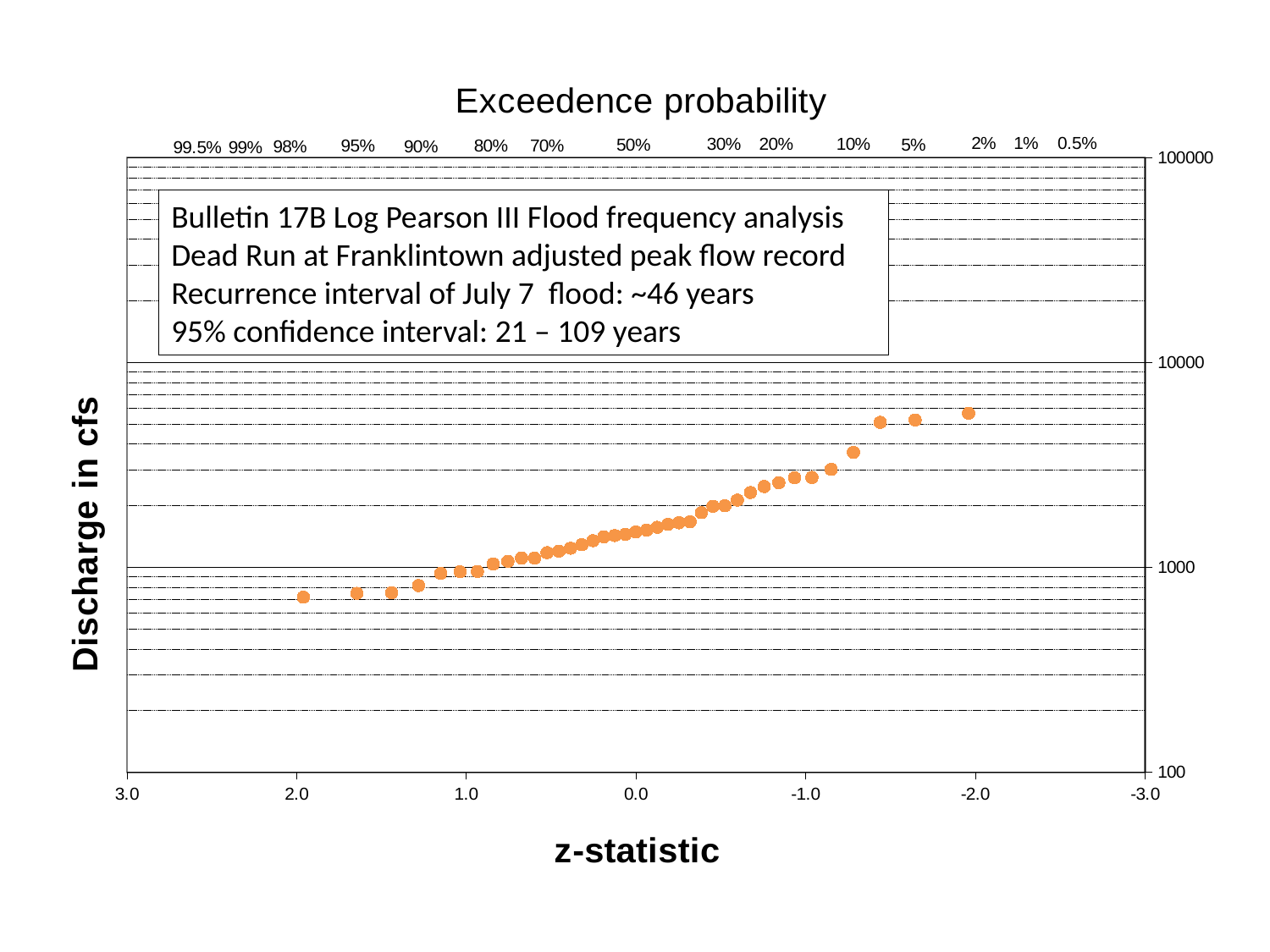
Is the discharge of the point near z-statistic 0.0 greater or less than 1000 cfs? greater What exceedance probability is shown on the top axis above z-statistic 0.0? 50% As the z-statistic decreases from 2.0 to -2.0 (moving right along the x axis), does the discharge rise or fall? rise What is the label of the y axis? Discharge in cfs Is the highest discharge point on the chart greater or less than 10000 cfs? less Near which z-statistic tick does the point with the lowest discharge occur? 2.0 Is the lowest discharge point on the chart greater or less than 100 cfs? greater Near which z-statistic tick does the point with the highest discharge occur? -2.0 What kind of chart is shown on the slide? scatter chart Which has the larger discharge: the point near z-statistic -2.0 or the point near z-statistic 2.0? the point near -2.0